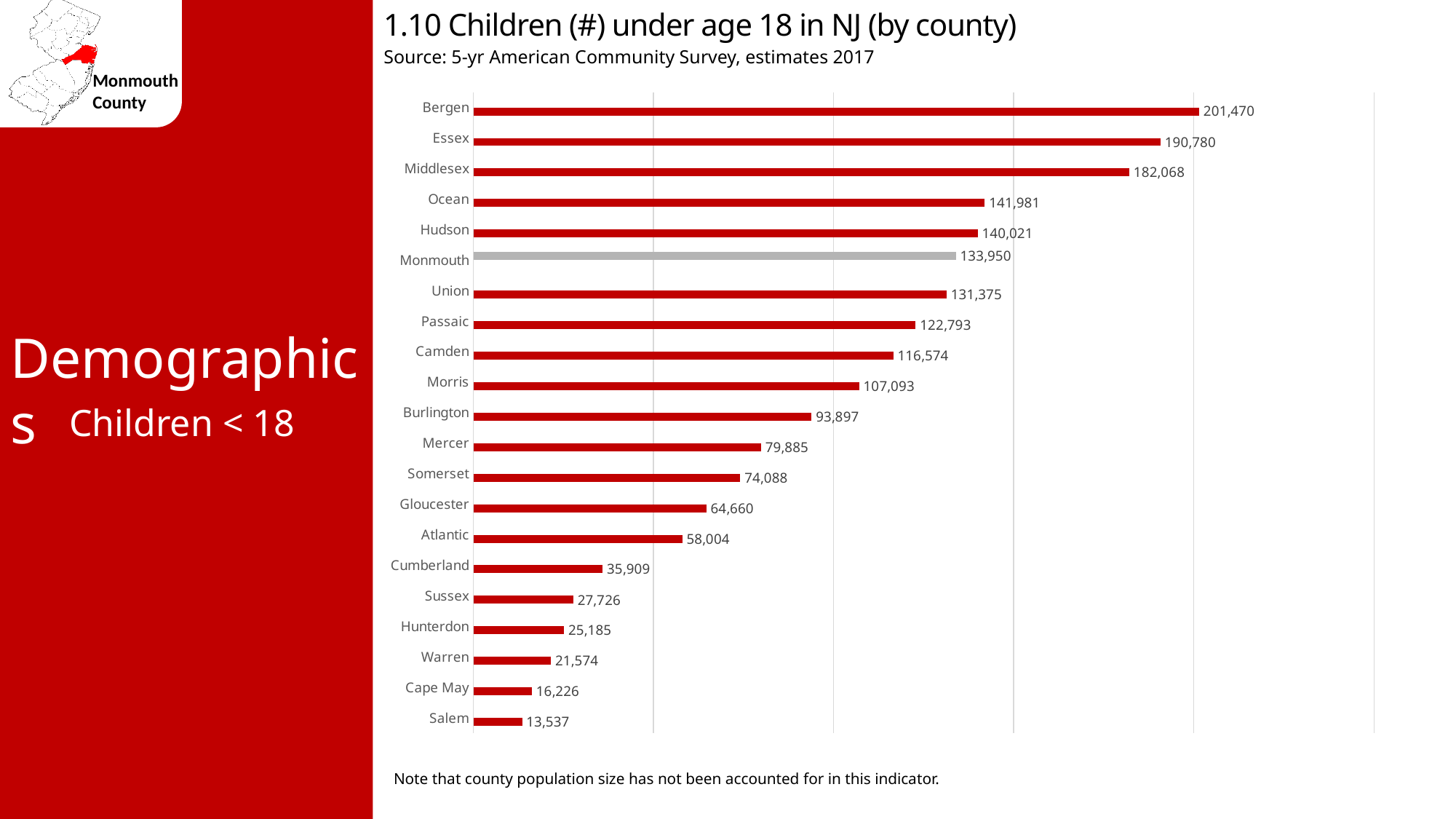
Which county has the highest number of children under age 18? Bergen Which county has the lowest number of children under age 18? Salem How many counties are shown in the chart? 21 Which county's bar is shown in gray instead of red? Monmouth What is the difference between the values for Bergen and Essex? 10,690 What is the value shown for Salem County? 13,537 What is the difference between the values for Monmouth and Union? 2,575 Which has more children under 18, Ocean or Hudson? Ocean What is the value shown for Bergen County? 201,470 What type of chart is used on this slide? Bar chart How many children under age 18 are in Monmouth County? 133,950 Which has more children under 18, Mercer or Somerset? Mercer